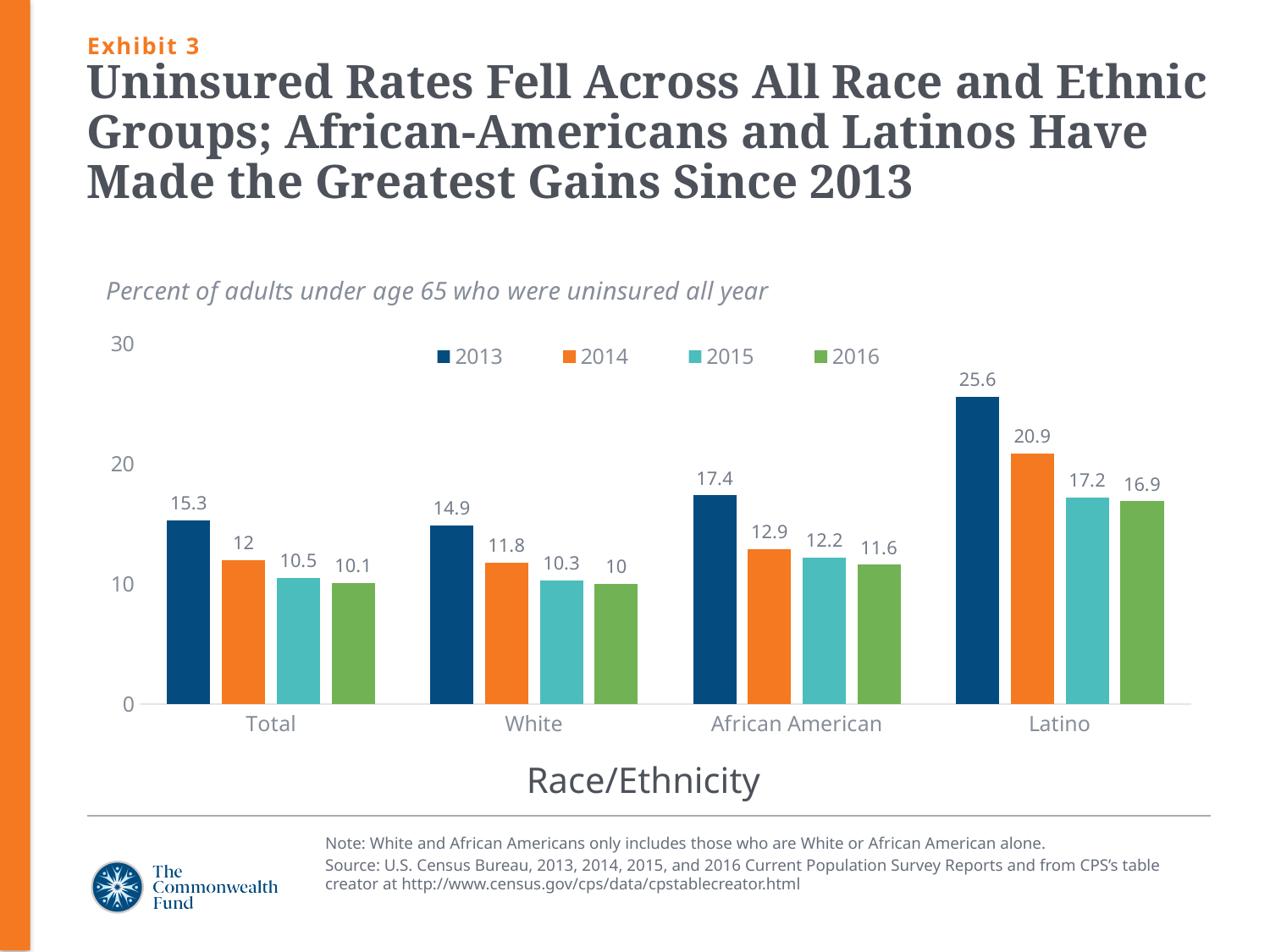
By how many percentage points did the uninsured rate for Latino adults fall from 2013 to 2016? 8.7 What was the uninsured rate for White adults in 2014? 11.8 What was the uninsured rate for Latino adults in 2013? 25.6 What is the difference between the 2013 uninsured rates for African American and White adults? 2.5 Which race/ethnicity group had the highest uninsured rate in 2013? Latino For the Total group, did the uninsured rate rise or fall from 2013 to 2016? Fall Which was larger in 2015: the uninsured rate for African American adults or for Latino adults? Latino Which race/ethnicity group had the lowest uninsured rate in 2016? White What kind of chart is shown on the slide? Bar chart What was the uninsured rate for African American adults in 2016? 11.6 How many race/ethnicity categories are shown on the x axis? 4 How many years (series) does the legend list? 4